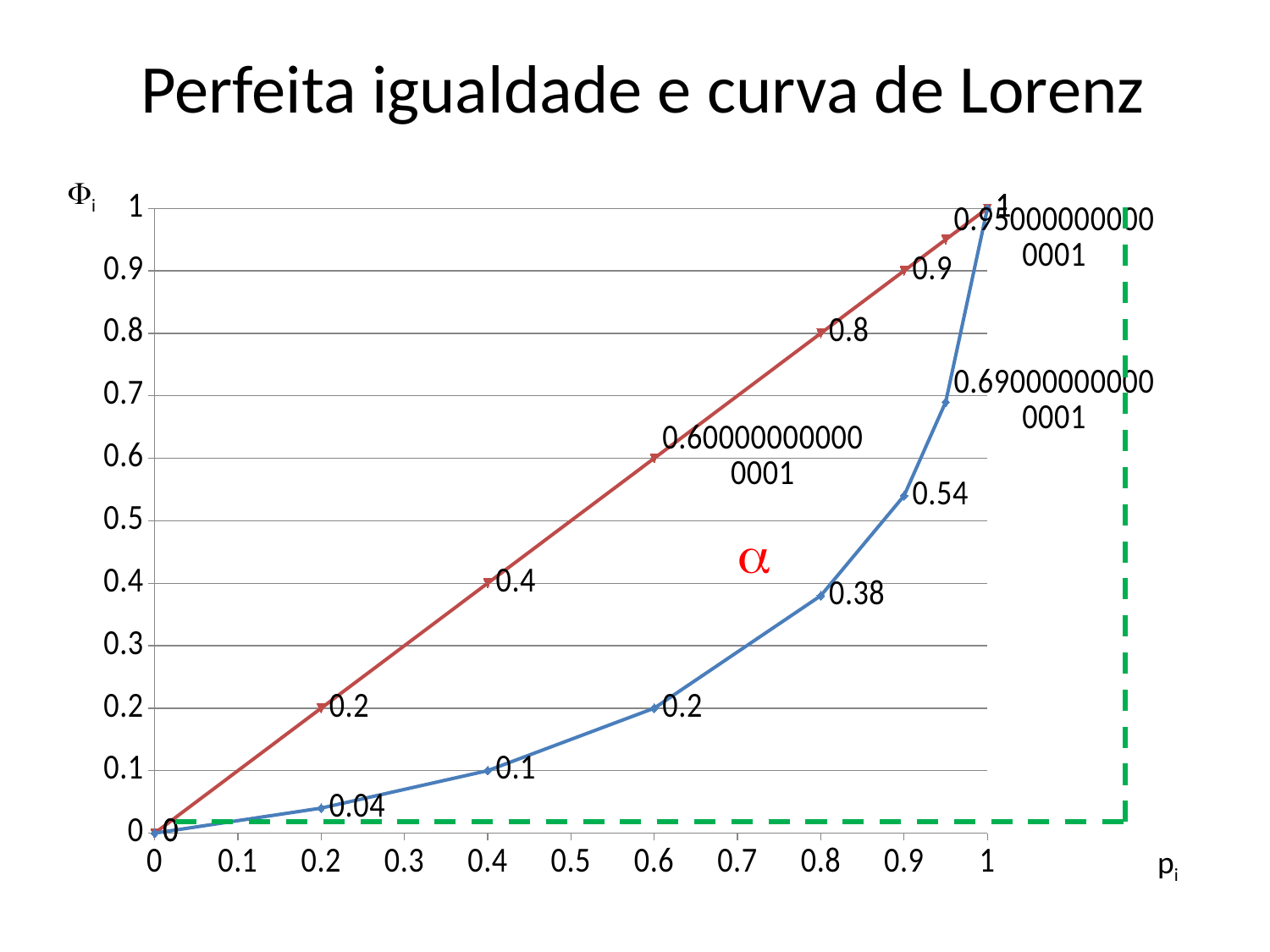
What is the value of the blue (Lorenz) curve at p = 0.8? 0.38 At p = 0.6, which series has the larger value, the red line or the blue curve? the red line What is the title of the chart on the slide? Perfeita igualdade e curva de Lorenz What is the value of the red (perfect equality) line at p = 0.4? 0.4 What is the value of the blue (Lorenz) curve at p = 0.2? 0.04 What kind of chart is shown on the slide? line chart What is the value of the blue (Lorenz) curve at p = 0.9? 0.54 Is the value of the blue curve at p = 0.8 greater or less than 0.5? less What is the difference between the red line value and the blue curve value at p = 0.8? 0.42 How many data points are plotted on the blue (Lorenz) curve? 8 What is the difference between the red line value and the blue curve value at p = 0.4? 0.3 Does the blue (Lorenz) curve rise or fall as p increases from 0 to 1? rises